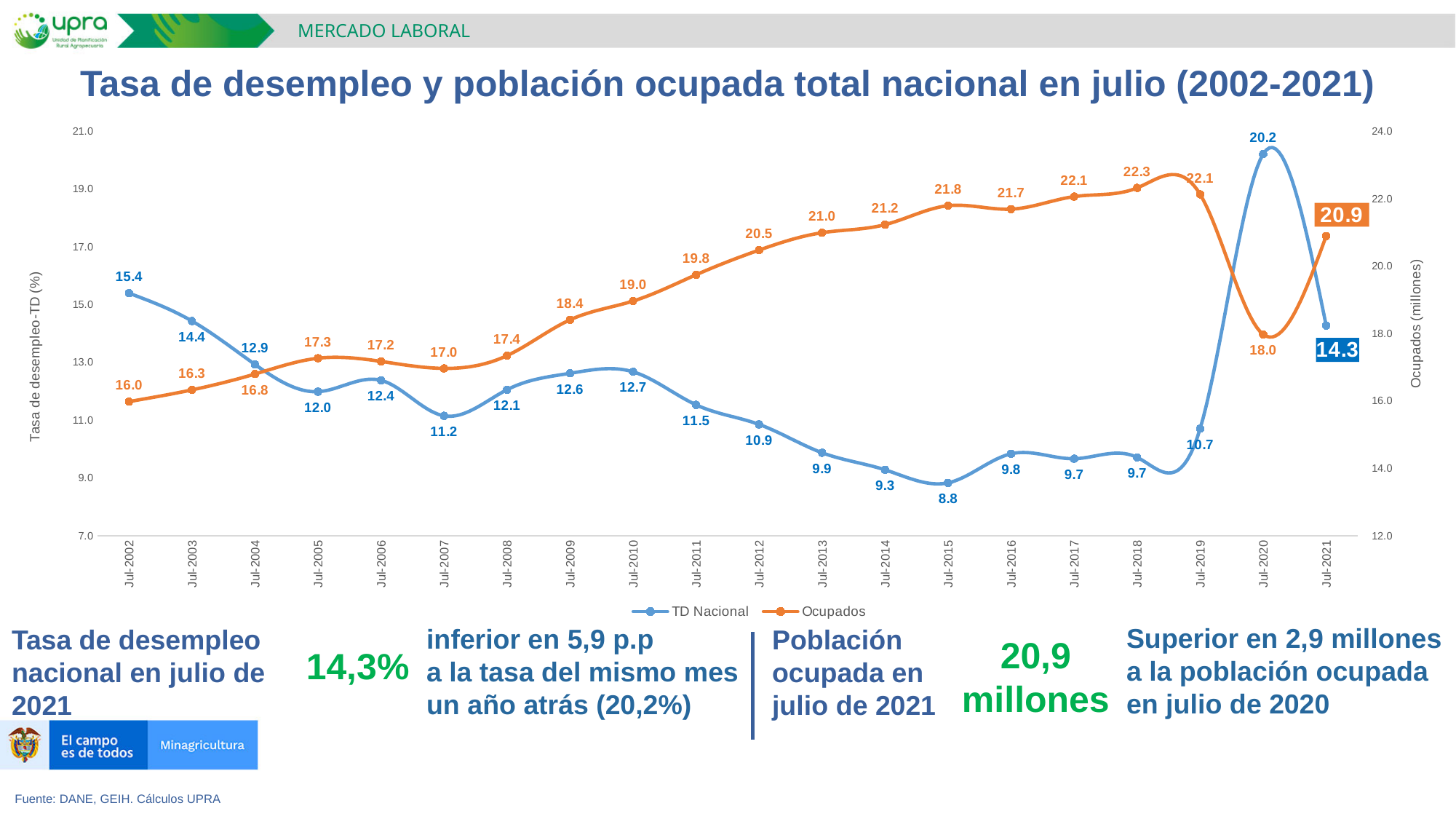
What kind of chart is shown on the slide? Line chart In which year does the Ocupados series reach its lowest value? Jul-2002 What is the difference between the TD Nacional values for Jul-2020 and Jul-2021? 5.9 Which is larger, the Ocupados value for Jul-2019 or for Jul-2020? Jul-2019 In which year does the TD Nacional series reach its highest value? Jul-2020 How many series does the legend list? 2 How many data points does each series have on the chart? 20 What is the TD Nacional value for Jul-2007? 11.2 What is the TD Nacional value for Jul-2021? 14.3 What is the Ocupados value for Jul-2018? 22.3 In which year does the TD Nacional series reach its lowest value? Jul-2015 What is the difference between the Ocupados values for Jul-2021 and Jul-2020? 2.9